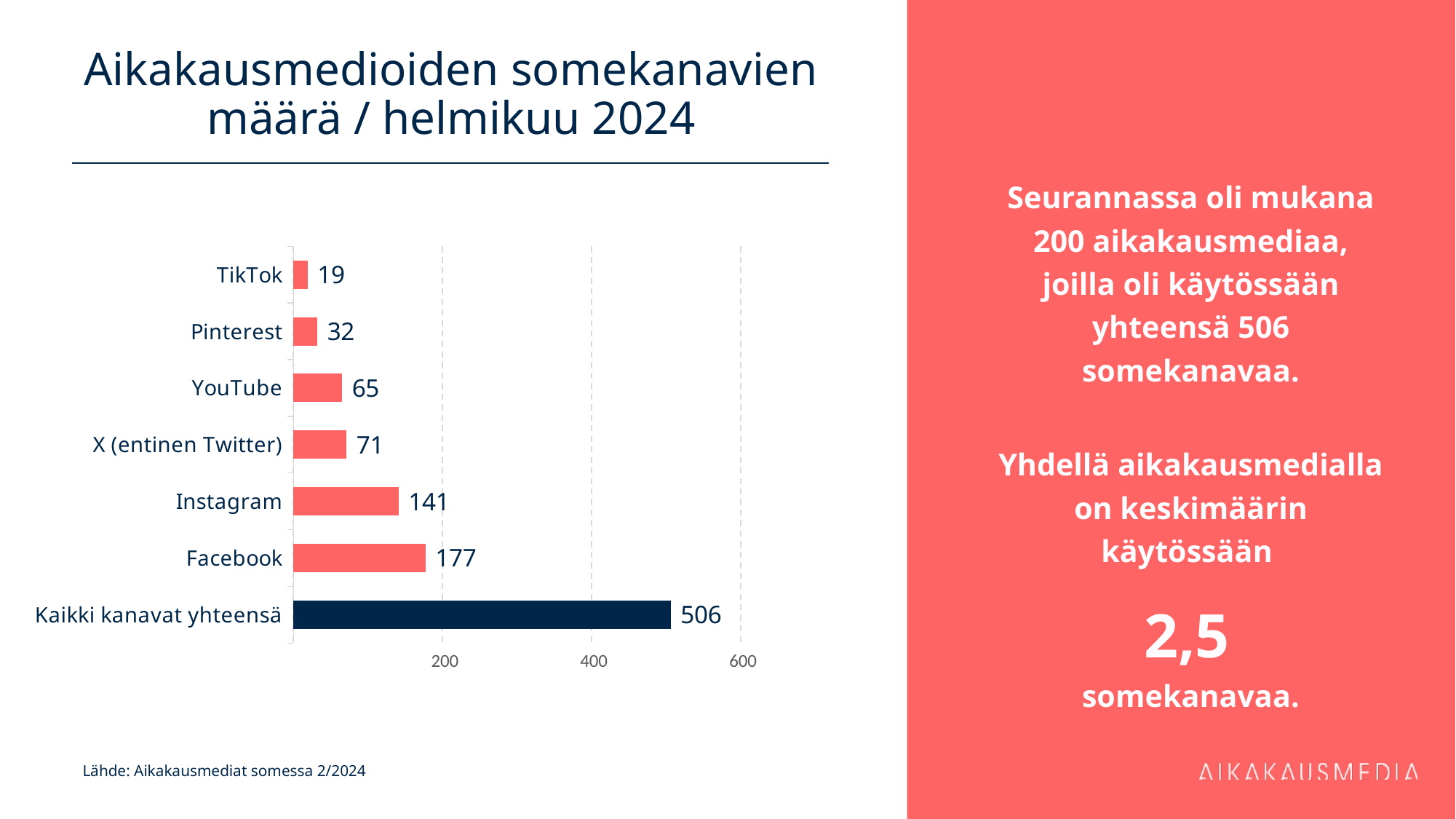
What is the value for Facebook? 177 Which is larger, the value for YouTube or the value for Pinterest? YouTube What kind of chart is shown on the slide? bar chart What is the value for X (entinen Twitter)? 71 Which individual channel (excluding the total bar) has the highest value? Facebook What is the title of the chart on the slide? Aikakausmedioiden somekanavien määrä / helmikuu 2024 What is the value for TikTok? 19 What is the value for Instagram? 141 What is the difference between the values for Facebook and Instagram? 36 Which category has the lowest value? TikTok Is the value for Kaikki kanavat yhteensä greater or less than 400? greater How many categories are shown in the chart? 7